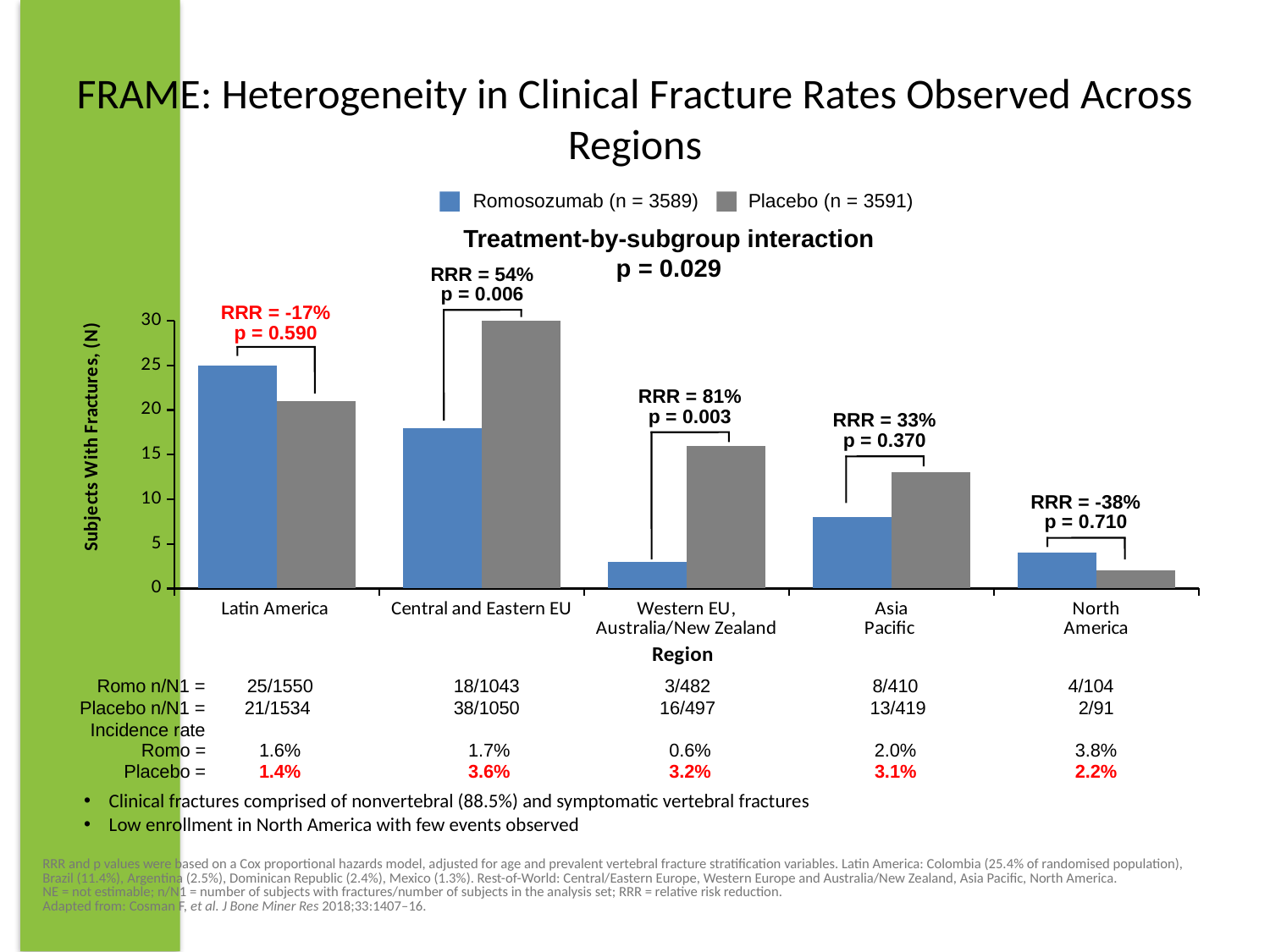
Which region has the lowest number of subjects with fractures in the Romosozumab group? Western EU, Australia/New Zealand How many subjects with fractures are shown for Romosozumab in Latin America? 25 What is the p value given for the treatment-by-subgroup interaction? 0.029 How many regions are shown along the x axis? 5 How many subjects with fractures are shown for Placebo in Western EU, Australia/New Zealand? 16 Is the Placebo value for Central and Eastern EU greater or less than 25? greater In Latin America, which group has more subjects with fractures, Romosozumab or Placebo? Romosozumab Which region has the highest number of subjects with fractures in the Romosozumab group? Latin America What kind of chart is shown on the slide? bar chart What RRR is annotated above the Western EU, Australia/New Zealand bars? 81% How many series does the legend list? 2 In Asia Pacific, how many more subjects with fractures are there in the Placebo group than in the Romosozumab group? 5